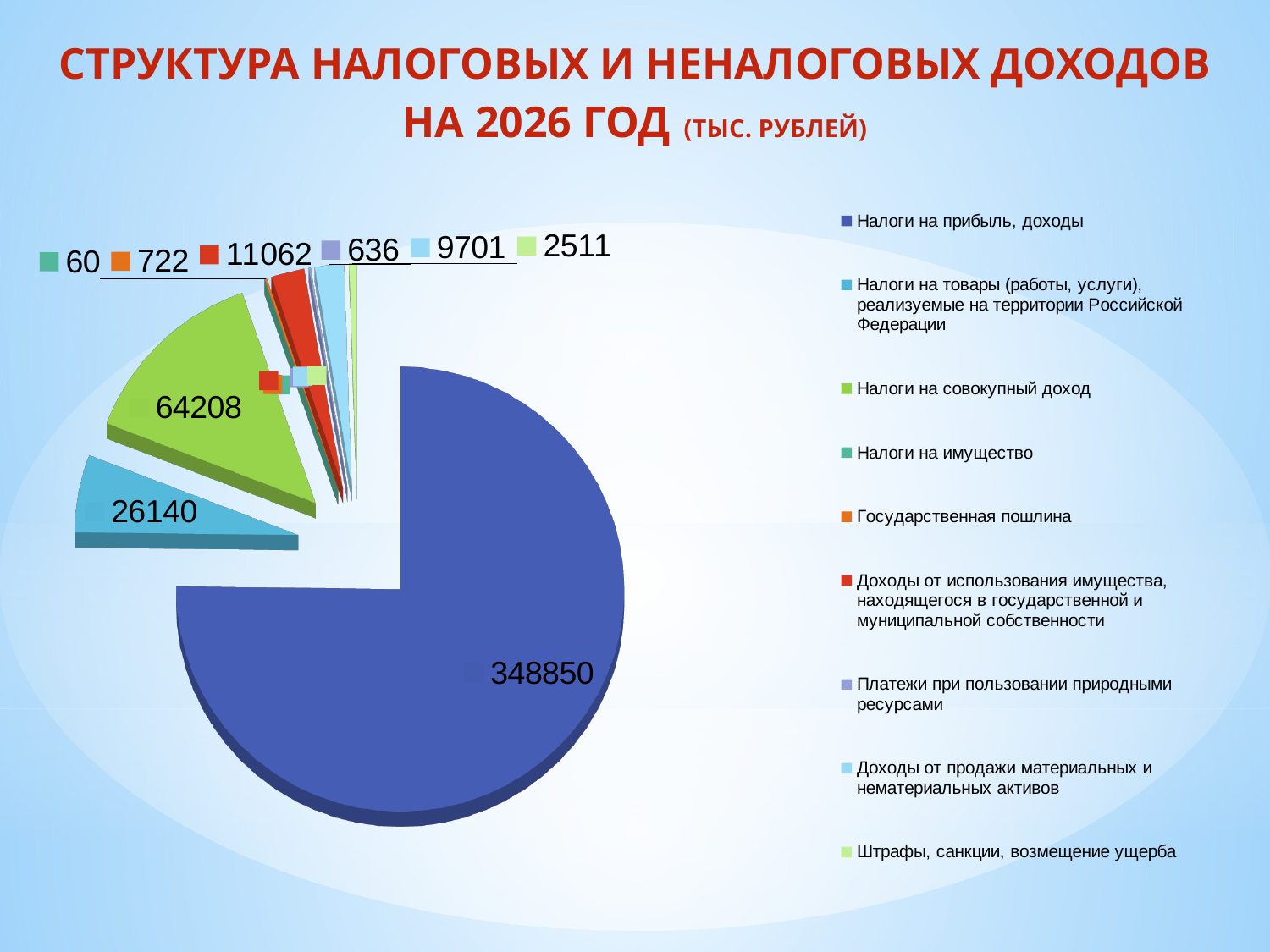
What unit is stated in the chart title? тыс. рублей What is the value for "Налоги на товары (работы, услуги), реализуемые на территории Российской Федерации"? 26140 What is the value for "Налоги на совокупный доход"? 64208 Which category has the largest value? Налоги на прибыль, доходы What is the value for "Налоги на прибыль, доходы"? 348850 Which category has the smallest value? Налоги на имущество How many categories does the legend list? 9 What is the value for "Штрафы, санкции, возмещение ущерба"? 2511 What type of chart is shown on the slide? pie chart What is the difference between "Налоги на совокупный доход" and "Налоги на товары (работы, услуги), реализуемые на территории Российской Федерации"? 38068 What is the value for "Доходы от использования имущества, находящегося в государственной и муниципальной собственности"? 11062 Which is larger: "Государственная пошлина" or "Платежи при пользовании природными ресурсами"? Государственная пошлина